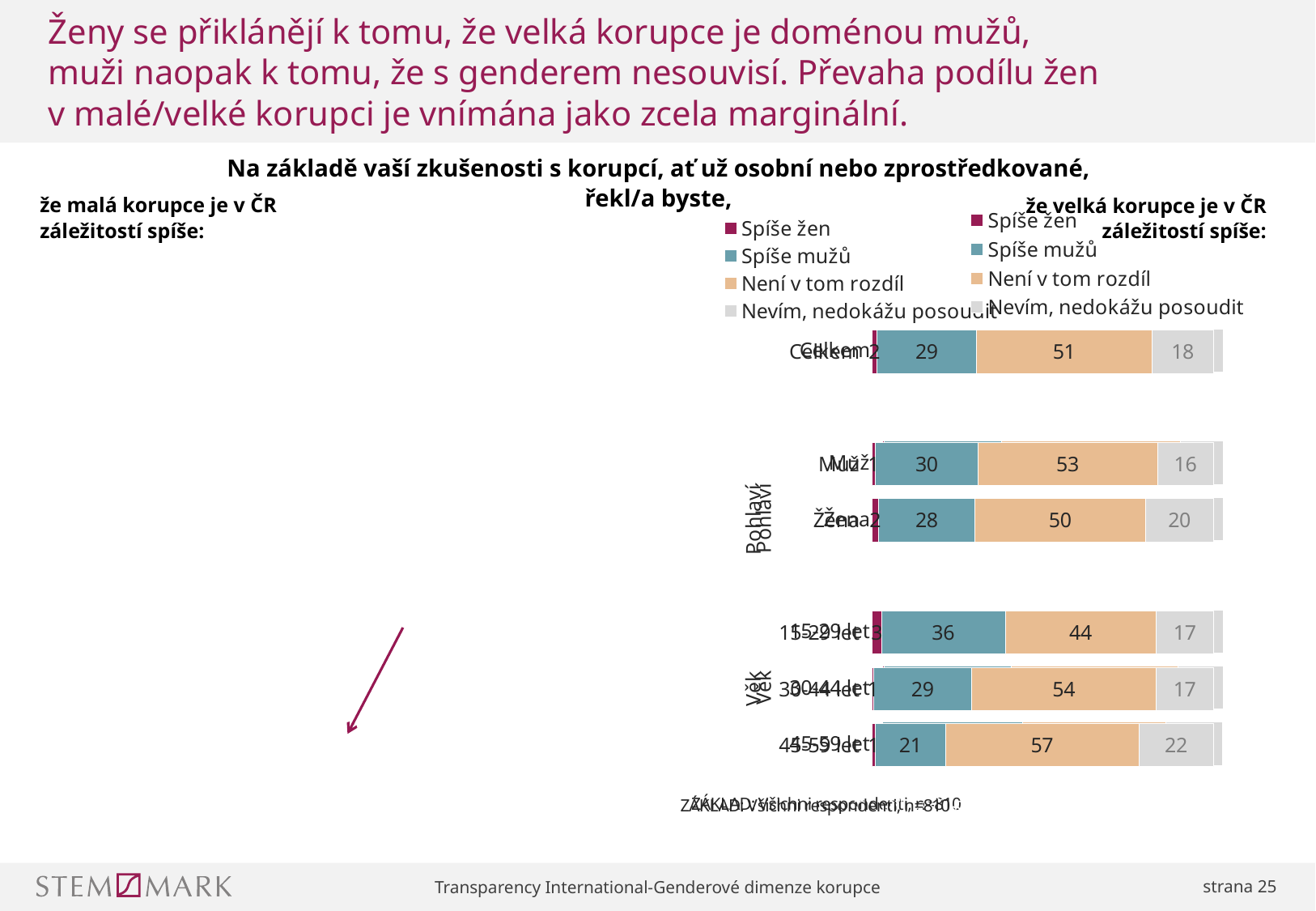
In the visible stacked bar chart on the right, which has the larger "Není v tom rozdíl" value: 15-29 let or 30-44 let? 30-44 let In the visible stacked bar chart on the right, what is the difference between the "Není v tom rozdíl" values for Muž and Žena? 3 In the visible stacked bar chart on the right, which age group has the lowest value for "Spíše mužů"? 45-59 let In the chart on the right, which colour represents "Není v tom rozdíl" in the legend? Orange (tan) What type of chart is shown on the right side of the slide? Stacked bar chart In the visible stacked bar chart on the right, what is the value for "Spíše mužů" in the 15-29 let bar? 36 In the visible stacked bar chart on the right, which age group has the highest value for "Spíše mužů"? 15-29 let In the visible stacked bar chart on the right, what is the value for "Nevím, nedokážu posoudit" in the Žena bar? 20 In the visible stacked bar chart on the right, what is the value for "Není v tom rozdíl" in the Celkem bar? 51 In the visible stacked bar chart on the right, what is the value for "Není v tom rozdíl" in the 45-59 let bar? 57 In the visible stacked bar chart on the right, what is the value for "Spíše mužů" in the Muž bar? 30 How many series does the legend of the chart on the right list? 4